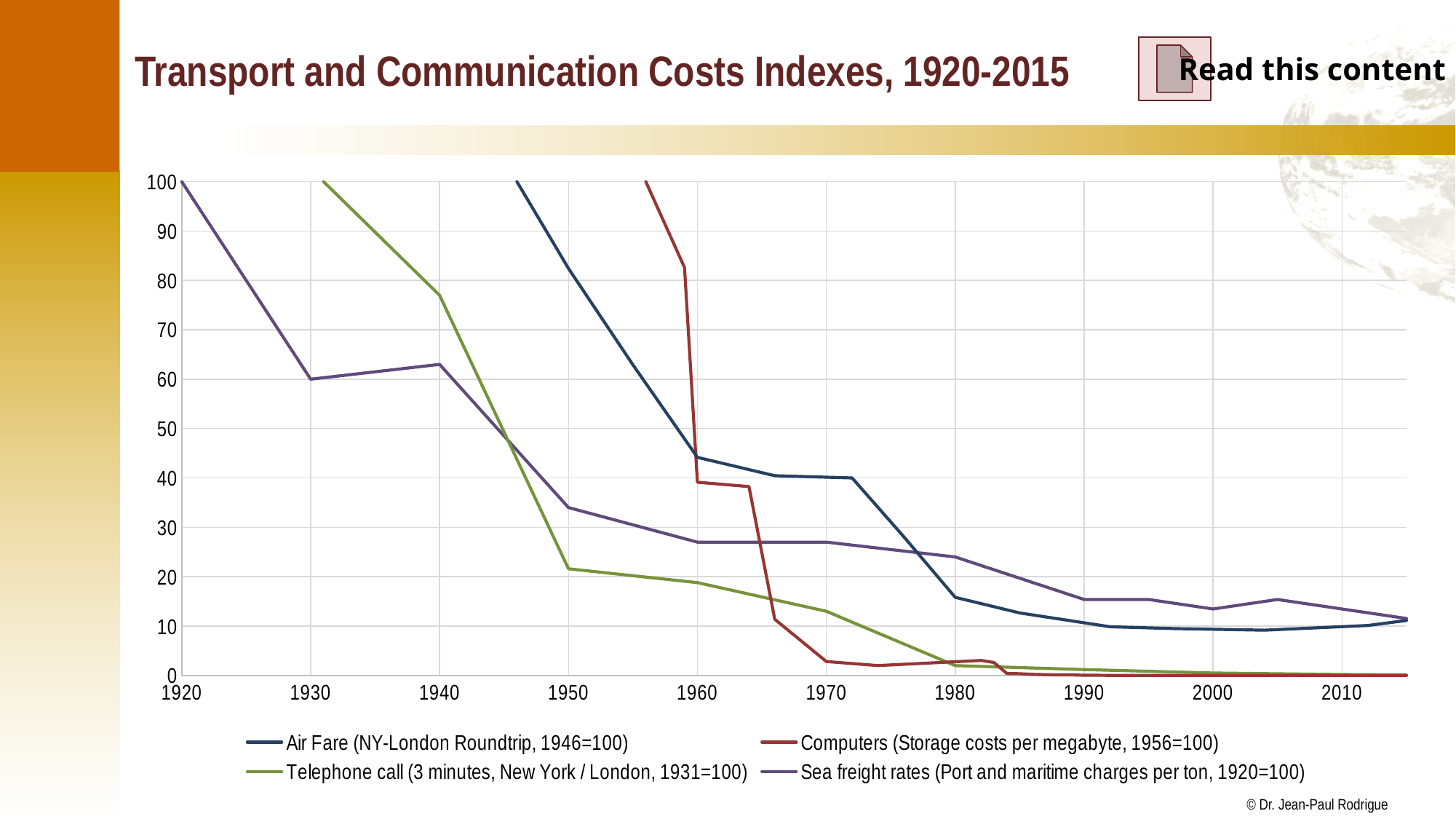
What kind of chart is shown on the slide? line chart Do the Telephone call index values rise or fall from 1931 to 2015? fall How many series does the legend list? 4 Which series has the higher value in 1960, Air Fare or Telephone call? Air Fare What is the value of the Sea freight rates index in 1920? 100 Which colour is used for the Computers series line? red Is the value of the Computers index in 1970 greater or less than 10? less What is the value of the Air Fare index in 1946? 100 Is the value of the Air Fare index in 1980 greater or less than 20? less What is the value of the Sea freight rates index in 1930? 60 Is the value of the Sea freight rates index in 1950 greater or less than 30? greater What is the title of the chart? Transport and Communication Costs Indexes, 1920-2015